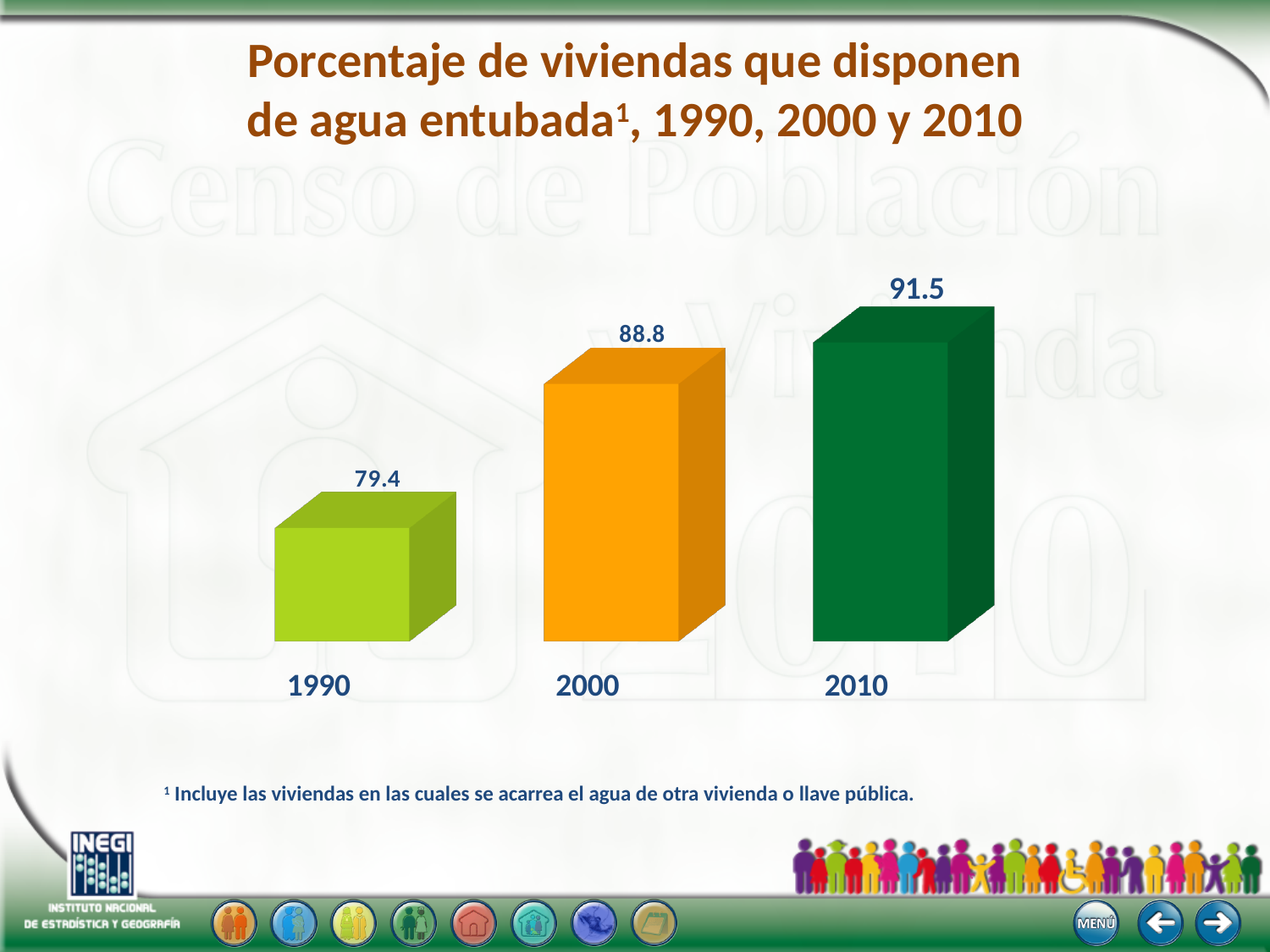
What is the value for 2000? 88.8 Which year has the highest value? 2010 What is the difference between the values for 2000 and 1990? 9.4 Which year has the lowest value? 1990 What is the value for 1990? 79.4 What colour is the bar for 2000? orange What is the value for 2010? 91.5 Which is larger, the value for 1990 or the value for 2000? 2000 How many years are shown in the chart? 3 What kind of chart is shown on the slide? bar chart Do the values rise or fall from 1990 to 2010? rise What is the difference between the values for 2010 and 2000? 2.7